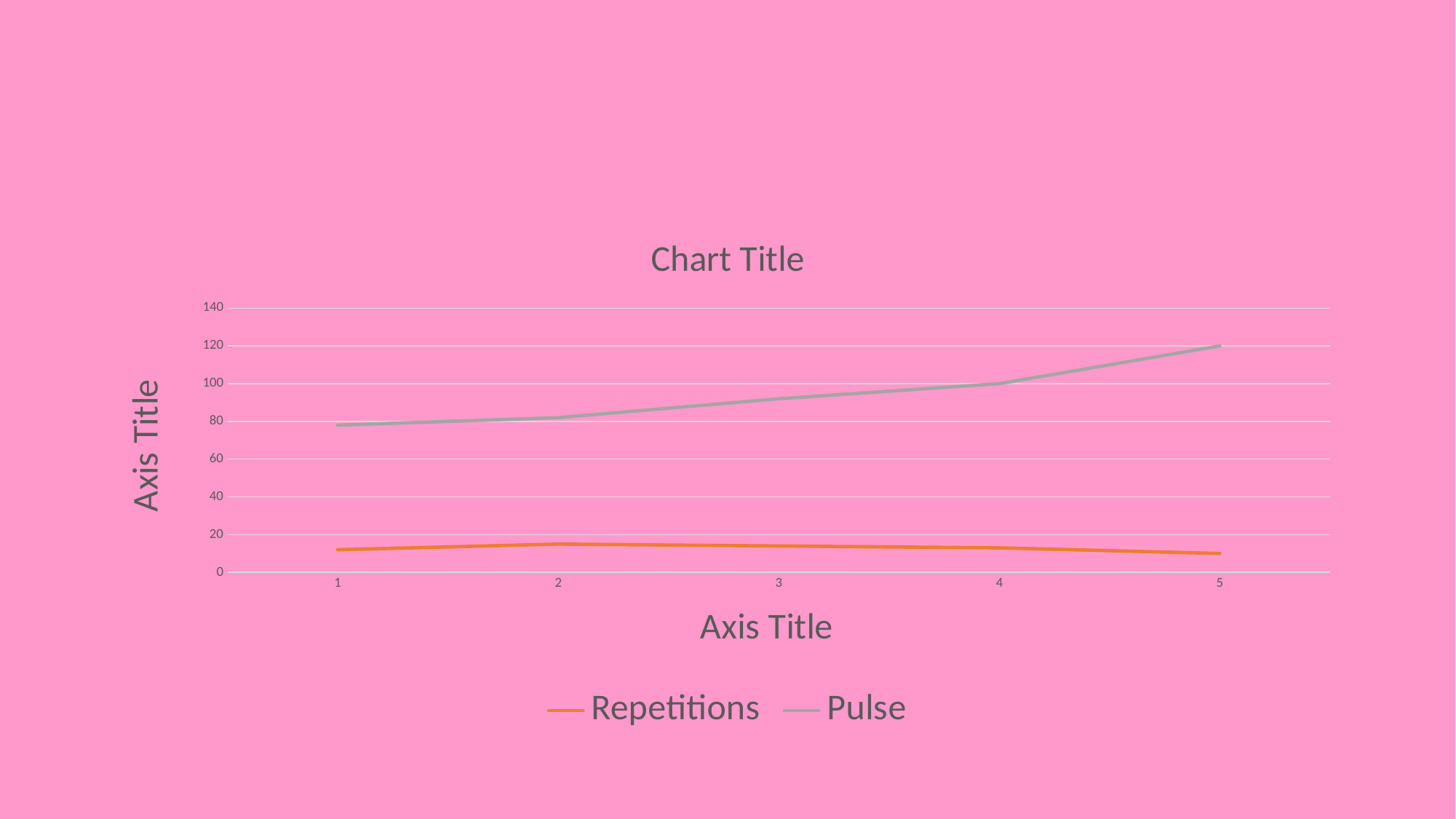
Is the Pulse value at point 3 greater or less than 80? greater At which x-axis point is the Pulse value highest? 5 What is the title of the chart? Chart Title Is the Pulse value at point 2 greater or less than 100? less What are the names of the two series in the legend? Repetitions and Pulse What kind of chart is shown on the slide? line chart Is the Repetitions value at point 2 greater or less than 20? less How many series does the legend list? 2 How many points are plotted along the x axis for each series? 5 Does the Pulse series rise or fall from point 1 to point 5? rise Which series has the larger value at point 3, Repetitions or Pulse? Pulse At which x-axis point is the Pulse value lowest? 1